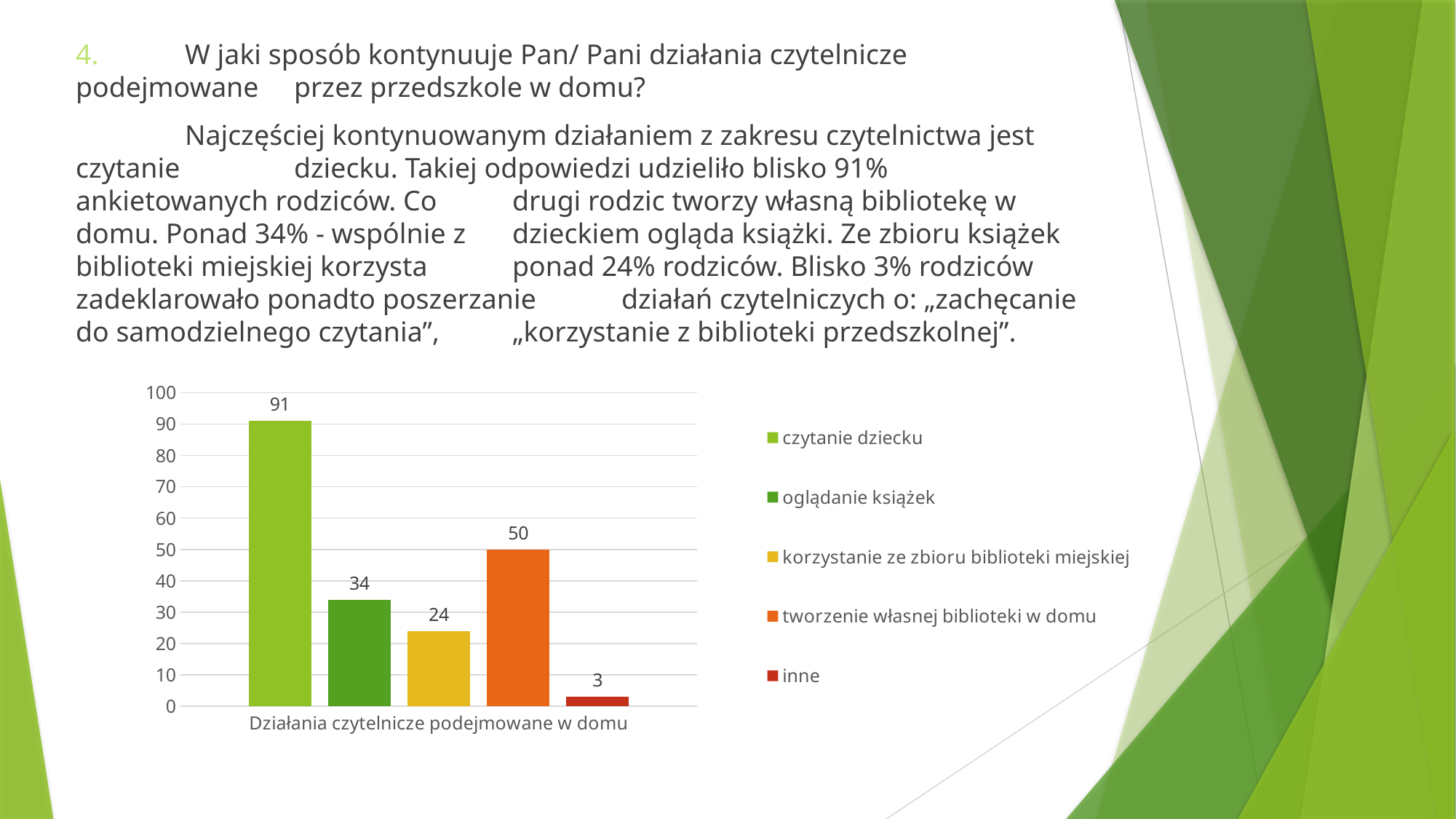
What value is shown for "korzystanie ze zbioru biblioteki miejskiej"? 24 Which series has the highest value? czytanie dziecku Which series has the lowest value? inne Which is larger, the value for "oglądanie książek" or the value for "tworzenie własnej biblioteki w domu"? tworzenie własnej biblioteki w domu What value is shown for "czytanie dziecku"? 91 What value is shown for "tworzenie własnej biblioteki w domu"? 50 What kind of chart is shown on the slide? bar chart What is the difference between the values for "oglądanie książek" and "korzystanie ze zbioru biblioteki miejskiej"? 10 What is the difference between the values for "czytanie dziecku" and "tworzenie własnej biblioteki w domu"? 41 How many series does the legend list? 5 What value is shown for "inne"? 3 What is the category label shown on the x axis of the chart? Działania czytelnicze podejmowane w domu